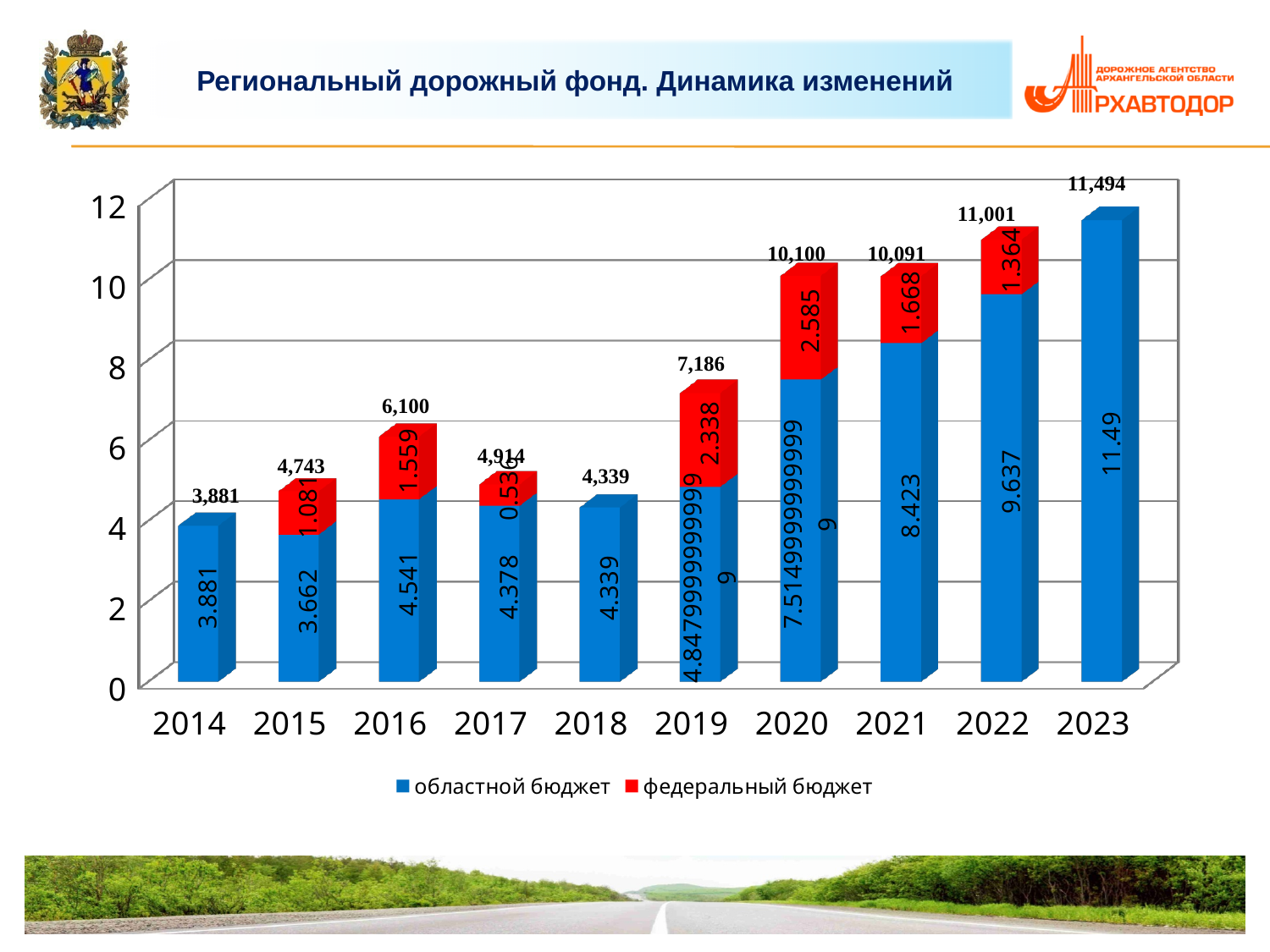
What is the total shown above the bar for 2019? 7,186 Which year has the lowest total value? 2014 What is the value of областной бюджет for 2022? 9.637 What type of chart is shown on the slide? stacked bar chart What is the value of областной бюджет for 2016? 4.541 What is the difference between the областной бюджет values for 2022 and 2021? 1.214 How many years are shown on the x axis? 10 Which series is shown in red in the legend? федеральный бюджет Which year has the highest total value? 2023 Which is larger, the федеральный бюджет value for 2021 or for 2022? 2021 How many series does the legend list? 2 What is the value of федеральный бюджет for 2020? 2.585